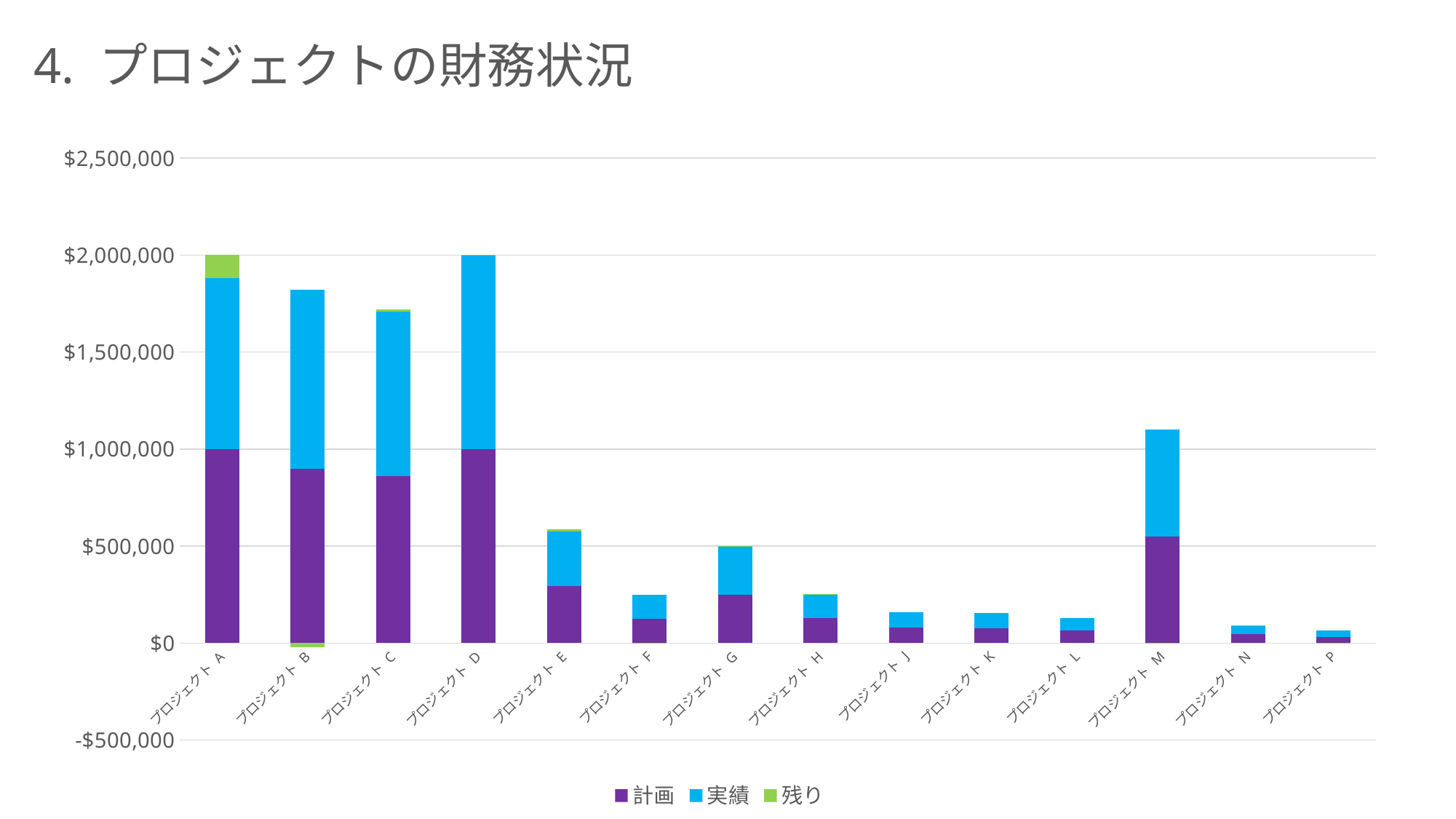
What kind of chart is shown on the slide? Stacked bar chart Is the 計画 value for プロジェクト B greater or less than $1,000,000? less Which project has the lowest total bar? プロジェクト P Which has the larger total bar, プロジェクト M or プロジェクト E? プロジェクト M How many projects (categories) are shown on the x axis? 14 Which colour represents the 残り series in the legend? Green Is the total bar for プロジェクト E greater or less than $500,000? greater Which has the larger 計画 value, プロジェクト A or プロジェクト B? プロジェクト A Which project shows a negative 残り segment below $0? プロジェクト B Is the total bar for プロジェクト F greater or less than $500,000? less How many series does the legend list? 3